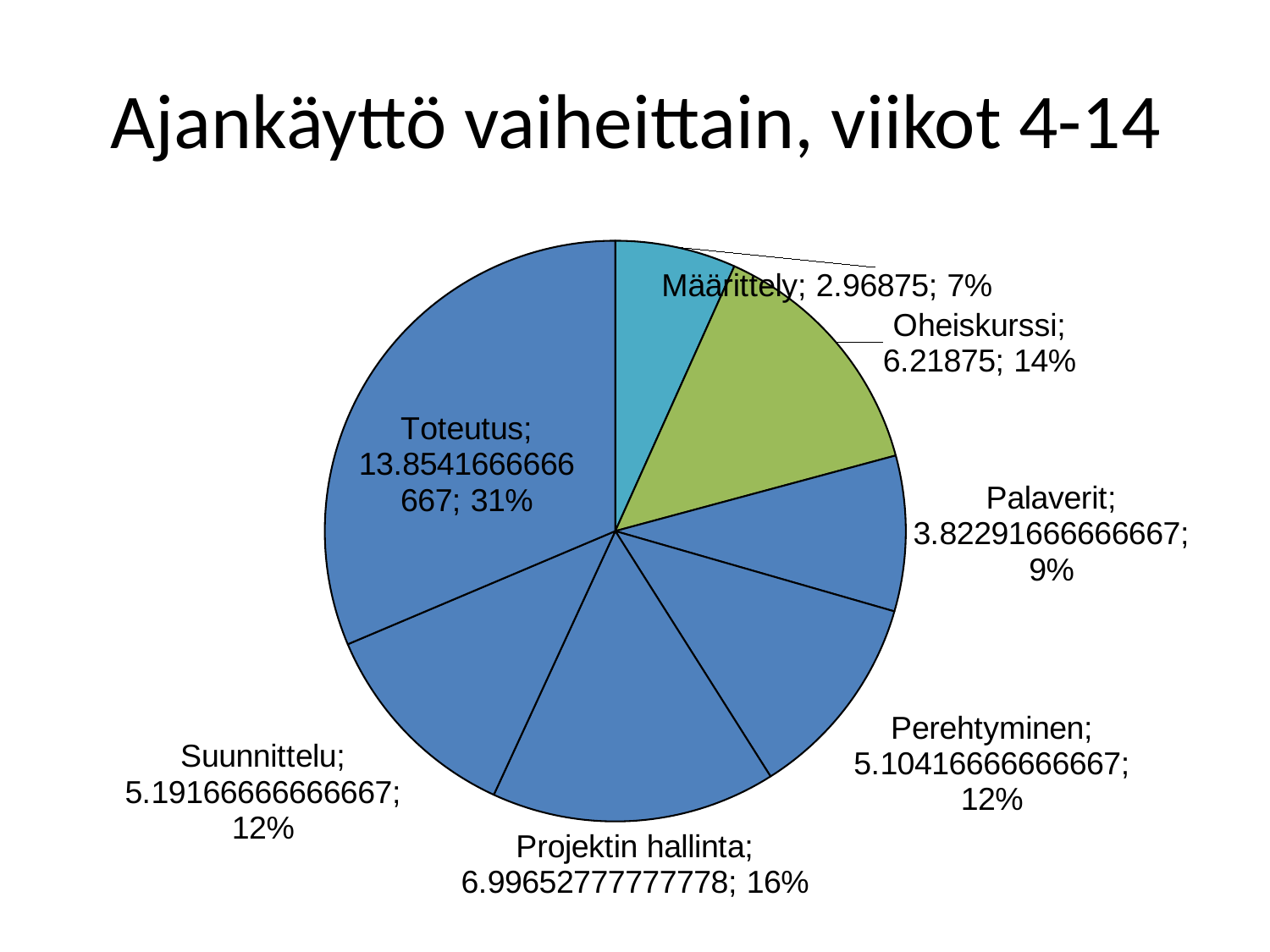
How many slices does the pie chart have? 7 What is the title of the chart? Ajankäyttö vaiheittain, viikot 4-14 What is the value shown for Projektin hallinta? 6.99652777777778 What percentage share does Oheiskurssi have? 14% What type of chart is shown on the slide? pie chart What is the value shown for Palaverit? 3.82291666666667 Which category has the smallest slice of the pie? Määrittely What percentage share does Toteutus have in the pie chart? 31% What is the value shown for Määrittely? 2.96875 What is the difference in percentage share between Oheiskurssi and Määrittely? 7% Which category has the largest slice of the pie? Toteutus Which has a larger share, Projektin hallinta or Oheiskurssi? Projektin hallinta